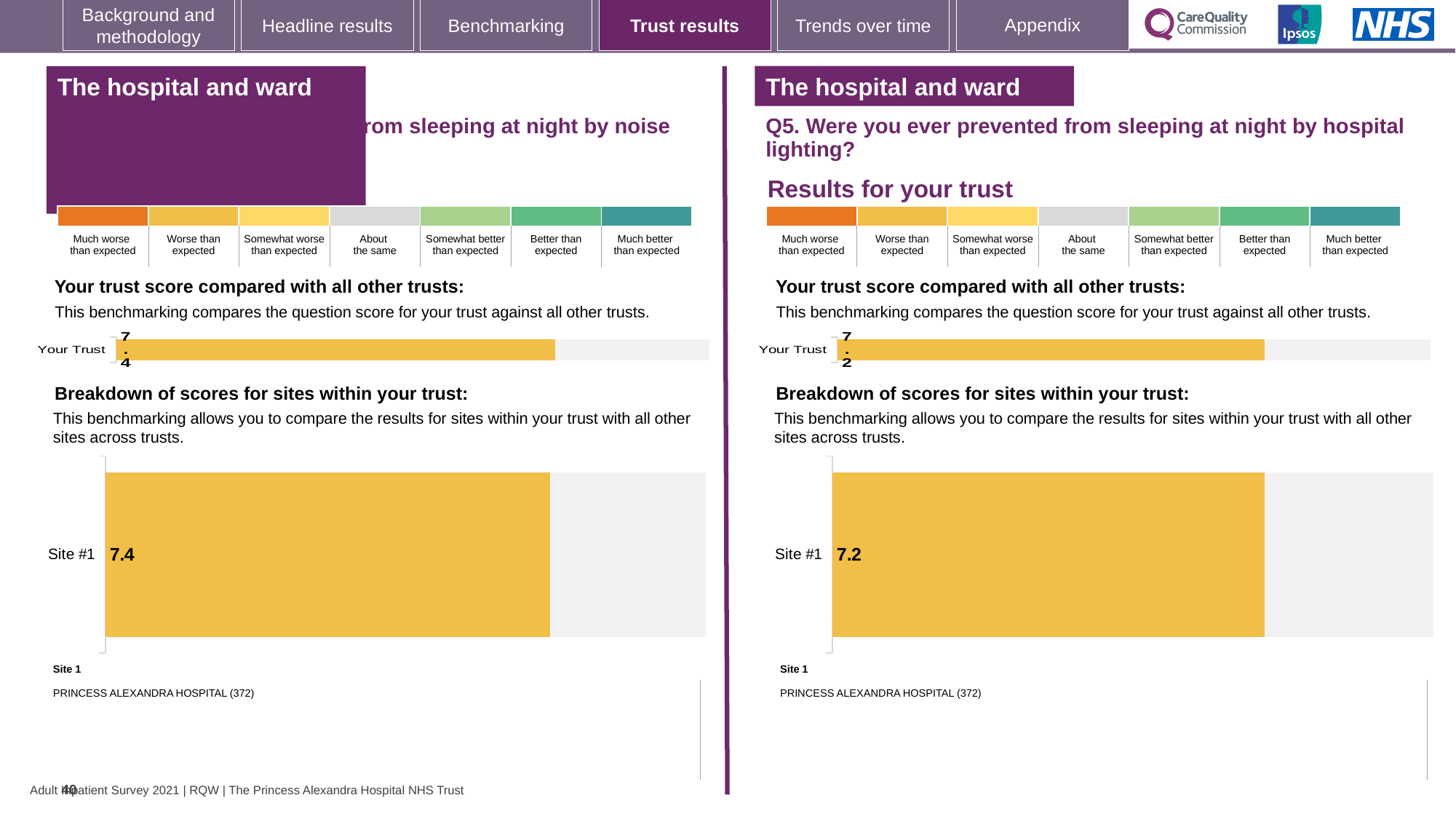
On the left-hand 'Your trust score compared with all other trusts' chart, what value is shown for Your Trust? 7.4 What kind of chart is used for the 'Breakdown of scores for sites within your trust' on the right-hand side of the slide? Bar chart How many sites are plotted on the right-hand 'Breakdown of scores for sites within your trust' chart? 1 On the right-hand 'Your trust score compared with all other trusts' chart (Q5, hospital lighting), what value is shown for Your Trust? 7.2 What is the category label on the left-hand 'Your trust score compared with all other trusts' bar chart? Your Trust Which Site #1 score is larger: the one on the left-hand site breakdown chart or the one on the right-hand (Q5, hospital lighting) site breakdown chart? The left-hand chart (7.4) What colour is the Site #1 bar on the right-hand 'Breakdown of scores for sites within your trust' chart? Yellow How many sites are plotted on the left-hand 'Breakdown of scores for sites within your trust' chart? 1 On the left-hand 'Breakdown of scores for sites within your trust' chart, what is the score shown for Site #1? 7.4 What is the difference between the Site #1 score on the left-hand site breakdown chart (7.4) and the Site #1 score on the right-hand site breakdown chart (7.2)? 0.2 On the right-hand 'Breakdown of scores for sites within your trust' chart (Q5, hospital lighting), what is the score shown for Site #1? 7.2